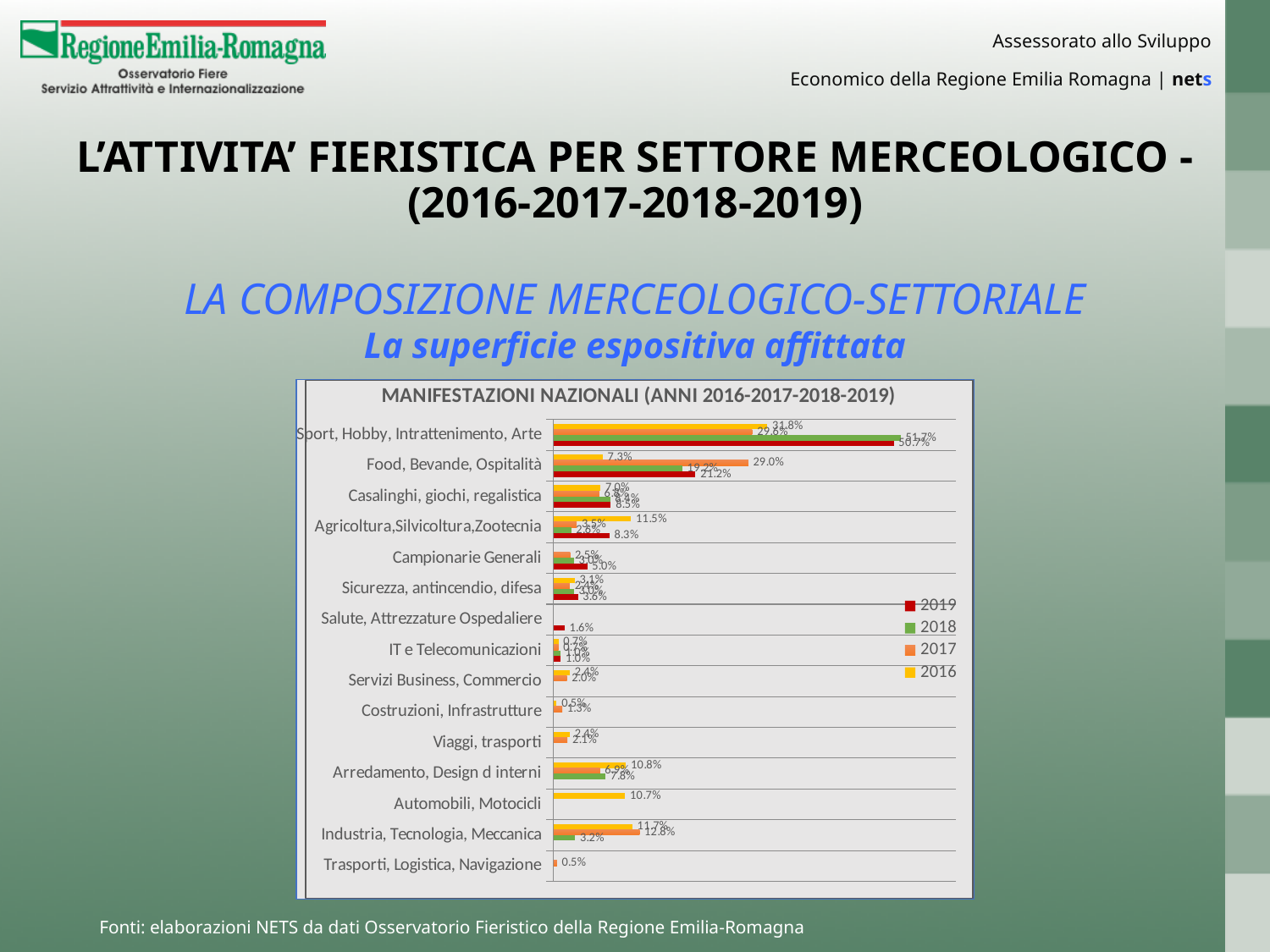
What is the 2018 value for Sport, Hobby, Intrattenimento, Arte? 51.7% What is the 2017 value for Food, Bevande, Ospitalità? 29.0% For Sport, Hobby, Intrattenimento, Arte, which is larger: the 2016 value or the 2018 value? 2018 How many categories are shown on the chart? 15 What is the title of the chart? MANIFESTAZIONI NAZIONALI (ANNI 2016-2017-2018-2019) What is the 2019 value for Sport, Hobby, Intrattenimento, Arte? 50.7% What is the 2019 value for Salute, Attrezzature Ospedaliere? 1.6% How many series does the legend list? 4 What type of chart is shown on the slide? Bar chart What is the difference between the 2018 and 2019 values for Sport, Hobby, Intrattenimento, Arte? 1.0% What is the 2016 value for Automobili, Motocicli? 10.7% Which category has the highest value in 2018? Sport, Hobby, Intrattenimento, Arte